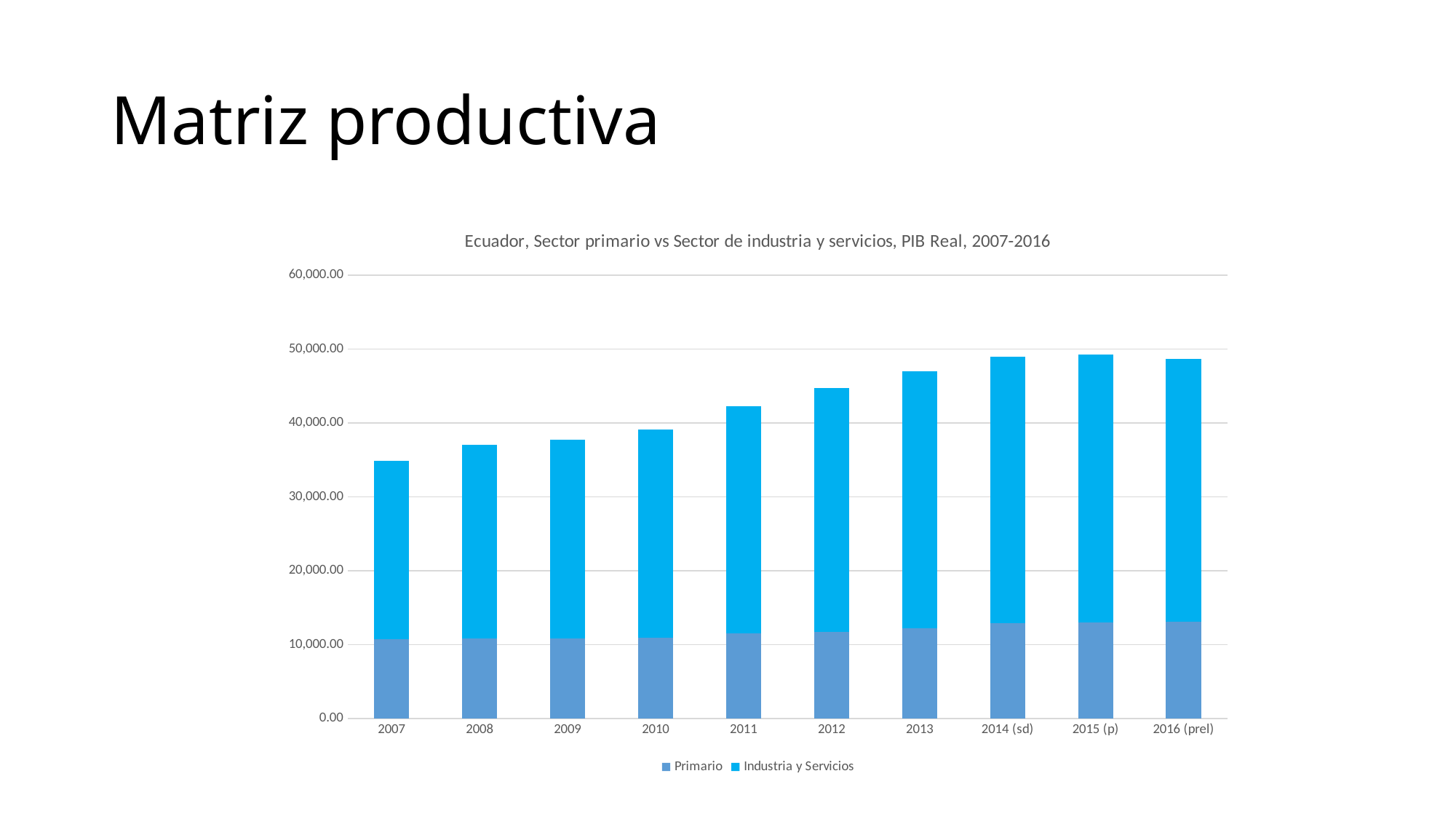
Is the Primario value for 2012 greater or less than 20,000.00? less How many years (categories) are shown on the x axis of the chart? 10 What kind of chart is shown on the slide? Stacked bar chart Which year has the lowest total bar height? 2007 Is the total bar height for 2007 greater or less than 40,000.00? less How many series does the chart's legend list? 2 Is the Primario value for 2016 (prel) greater or less than 10,000.00? greater Which has the larger total bar height, 2007 or 2013? 2013 Do the total bar heights generally rise or fall from 2007 to 2015 (p)? rise What is the title of the chart? Ecuador, Sector primario vs Sector de industria y servicios, PIB Real, 2007-2016 What are the two series named in the legend? Primario and Industria y Servicios